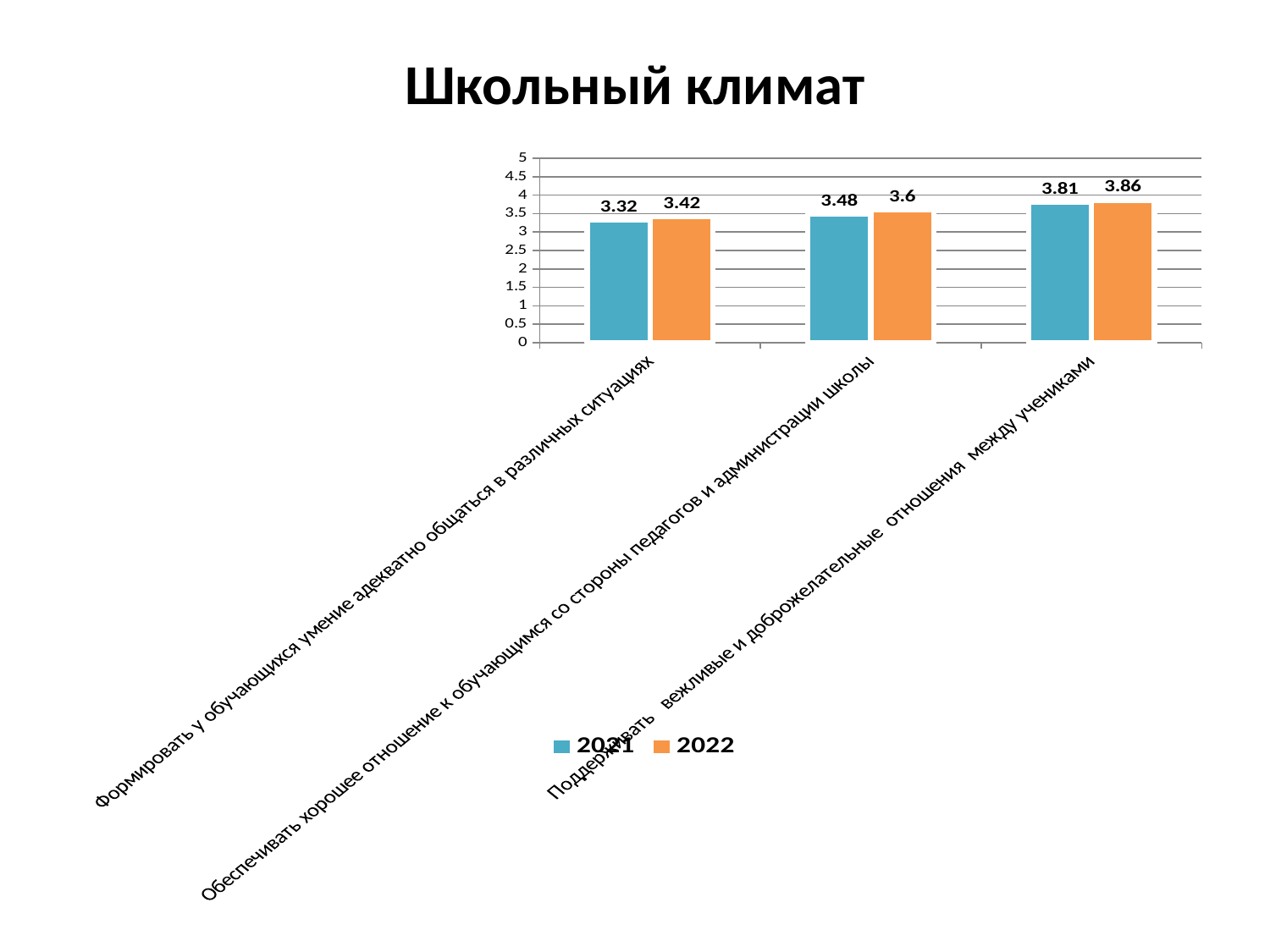
Which category has the highest value for 2022? Поддерживать вежливые и доброжелательные отношения между учениками How many series does the legend list? 2 What is the value for 2021 for the category "Формировать у обучающихся умение адекватно общаться в различных ситуациях"? 3.32 Which category has the lowest value for 2021? Формировать у обучающихся умение адекватно общаться в различных ситуациях What kind of chart is shown on the slide? bar chart What is the difference between the 2022 and 2021 values for the category "Формировать у обучающихся умение адекватно общаться в различных ситуациях"? 0.1 Which is larger for the category "Обеспечивать хорошее отношение к обучающимся со стороны педагогов и администрации школы": the 2021 value or the 2022 value? 2022 What is the value for 2022 for the category "Обеспечивать хорошее отношение к обучающимся со стороны педагогов и администрации школы"? 3.6 What is the title of the slide? Школьный климат How many categories are shown on the x axis of the chart? 3 Is the 2022 value for "Поддерживать вежливые и доброжелательные отношения между учениками" greater or less than 3.5? greater What is the value for 2021 for the category "Поддерживать вежливые и доброжелательные отношения между учениками"? 3.81